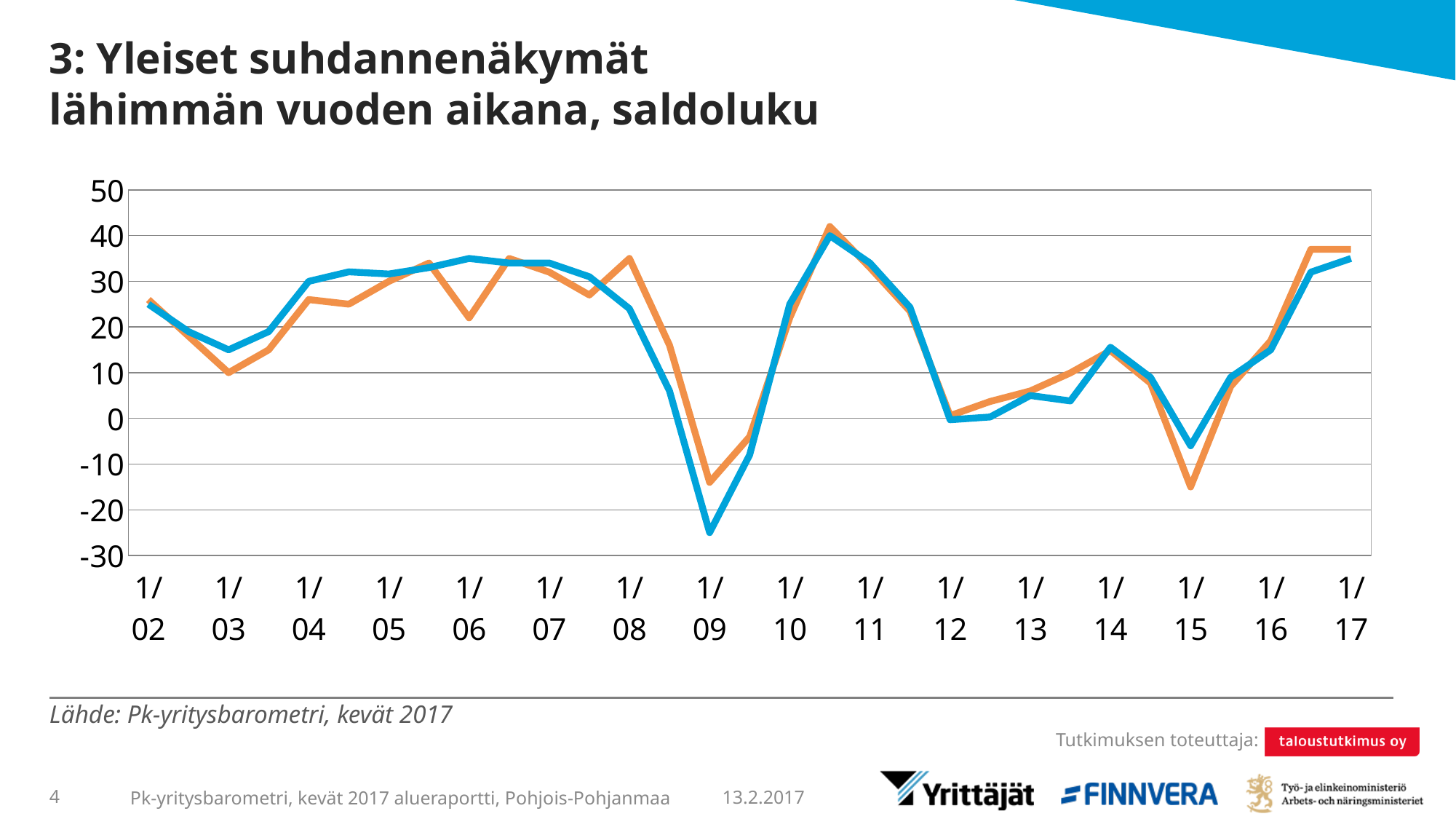
How many lines are plotted on the chart? 2 What is the title of the chart on the slide? 3: Yleiset suhdannenäkymät lähimmän vuoden aikana, saldoluku At which x-axis label does the blue line reach its lowest value? 1/09 At 1/15, which line has the higher value, the blue or the orange? blue At 1/09, which line has the higher value, the blue or the orange? orange Is the value of the orange line at 1/03 greater or less than 20? less How many x-axis labels (time points) are shown on the chart? 16 Is the value of the blue line at 1/17 greater or less than 30? greater What kind of chart is shown on the slide? line chart Is the value of the orange line at 1/15 greater or less than -10? less Between 1/16 and 1/17, does the blue line rise or fall? rise